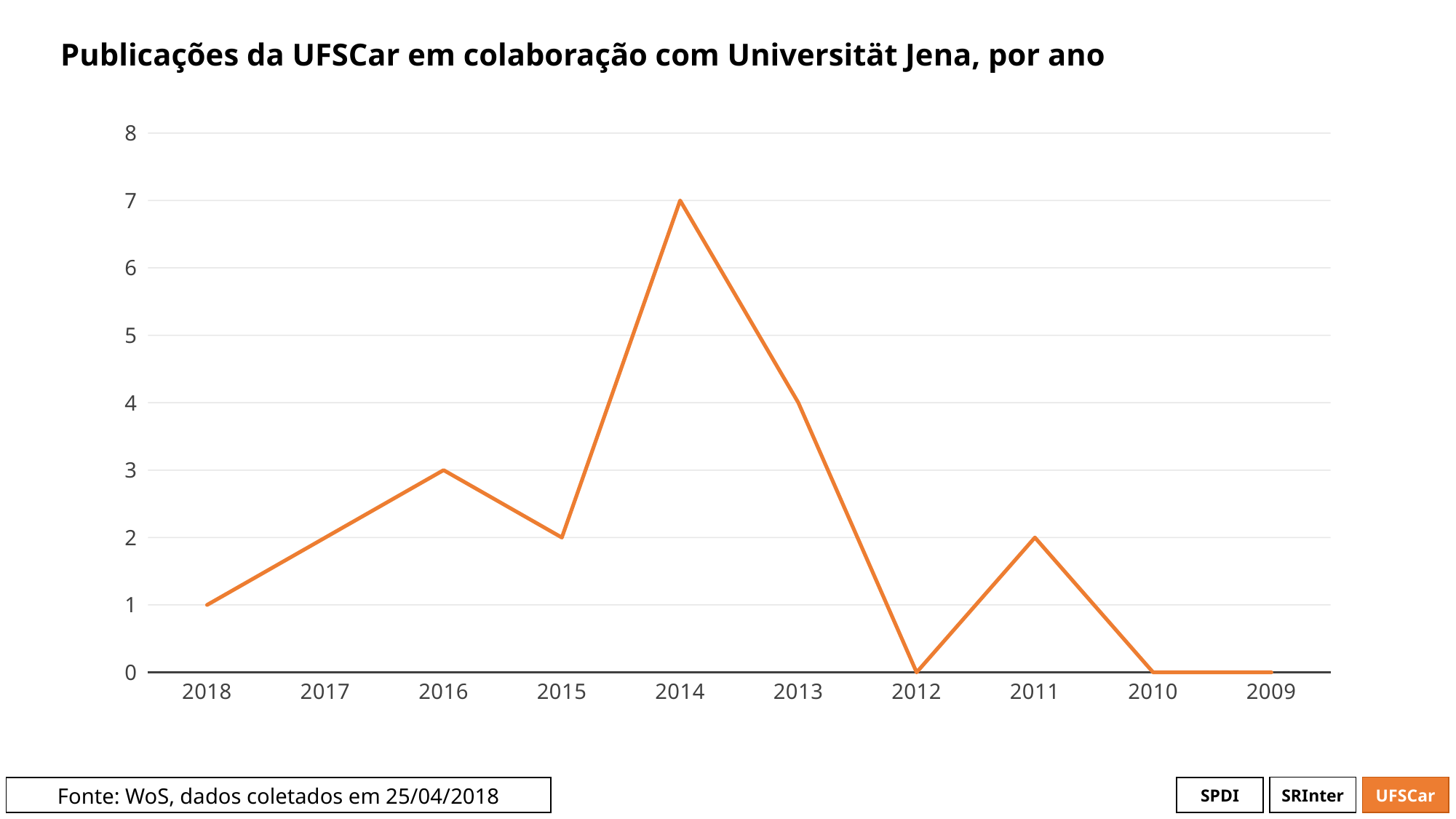
How many years are shown on the x axis? 10 What type of chart is shown on the slide? line chart How many publications are shown for 2013? 4 Does the line rise or fall from 2014 to 2012? fall What is the title of the chart? Publicações da UFSCar em colaboração com Universität Jena, por ano What is the difference between the values for 2014 and 2013? 3 Is the value for 2014 greater or less than 5? greater Which year has the highest number of publications? 2014 Which year has the larger value, 2016 or 2015? 2016 How many publications are shown for 2014? 7 How many publications are shown for 2016? 3 How many publications are shown for 2018? 1